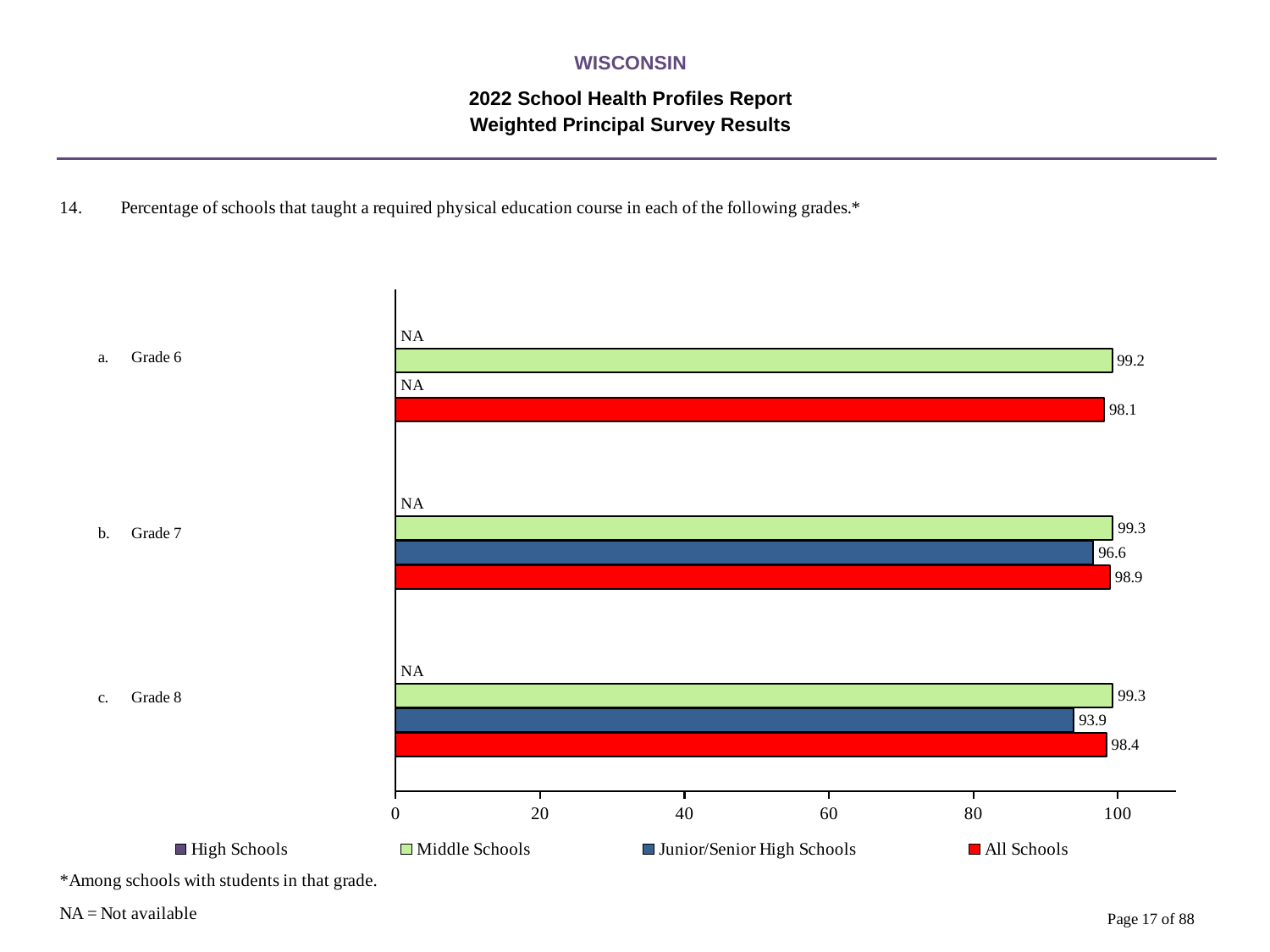
What is the value for All Schools in Grade 6? 98.1 How many series does the legend list? 4 Which grade has the lowest value for Junior/Senior High Schools? Grade 8 What is the value for All Schools in Grade 7? 98.9 Which is larger for Grade 7: the Middle Schools value or the Junior/Senior High Schools value? Middle Schools What is the value for Junior/Senior High Schools in Grade 8? 93.9 What kind of chart is shown on the slide? Bar chart What is the value for Middle Schools in Grade 6? 99.2 How many grade categories are shown on the chart? 3 What is the value for Junior/Senior High Schools in Grade 7? 96.6 What value is shown for High Schools in Grade 6? NA What is the difference between the Middle Schools and Junior/Senior High Schools values for Grade 8? 5.4